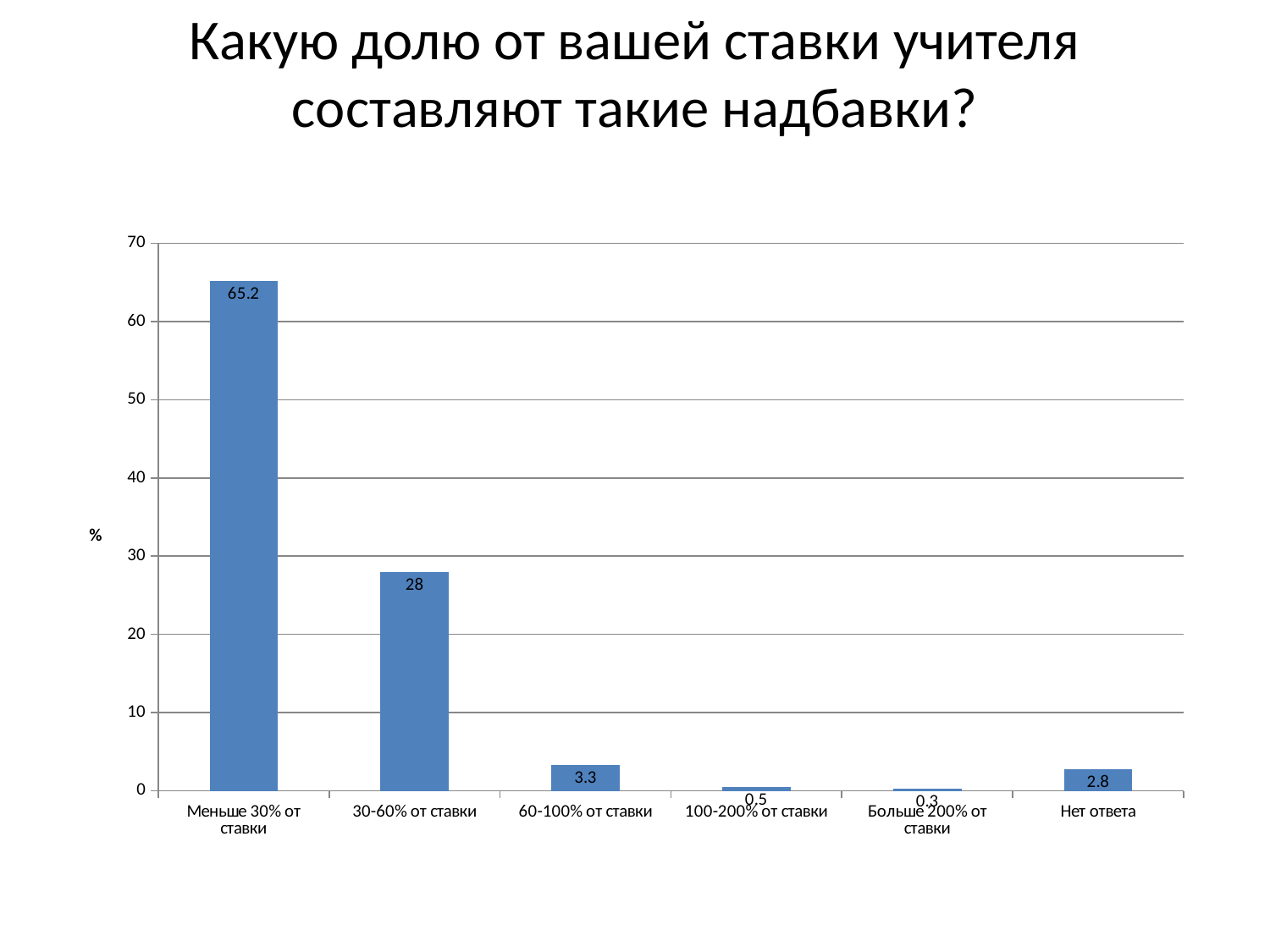
Which category has the lowest value? Больше 200% от ставки How many categories are shown on the x axis? 6 What is the value for "30-60% от ставки"? 28 What is the value for "60-100% от ставки"? 3.3 What is the difference between the values for "Меньше 30% от ставки" and "30-60% от ставки"? 37.2 Which category has the highest value? Меньше 30% от ставки What is the value for "Меньше 30% от ставки"? 65.2 Which is larger, the value for "60-100% от ставки" or the value for "Нет ответа"? 60-100% от ставки Is the value for "30-60% от ставки" greater or less than 30? less What kind of chart is shown on the slide? bar chart What is the value for "Нет ответа"? 2.8 What is the label on the vertical axis? %